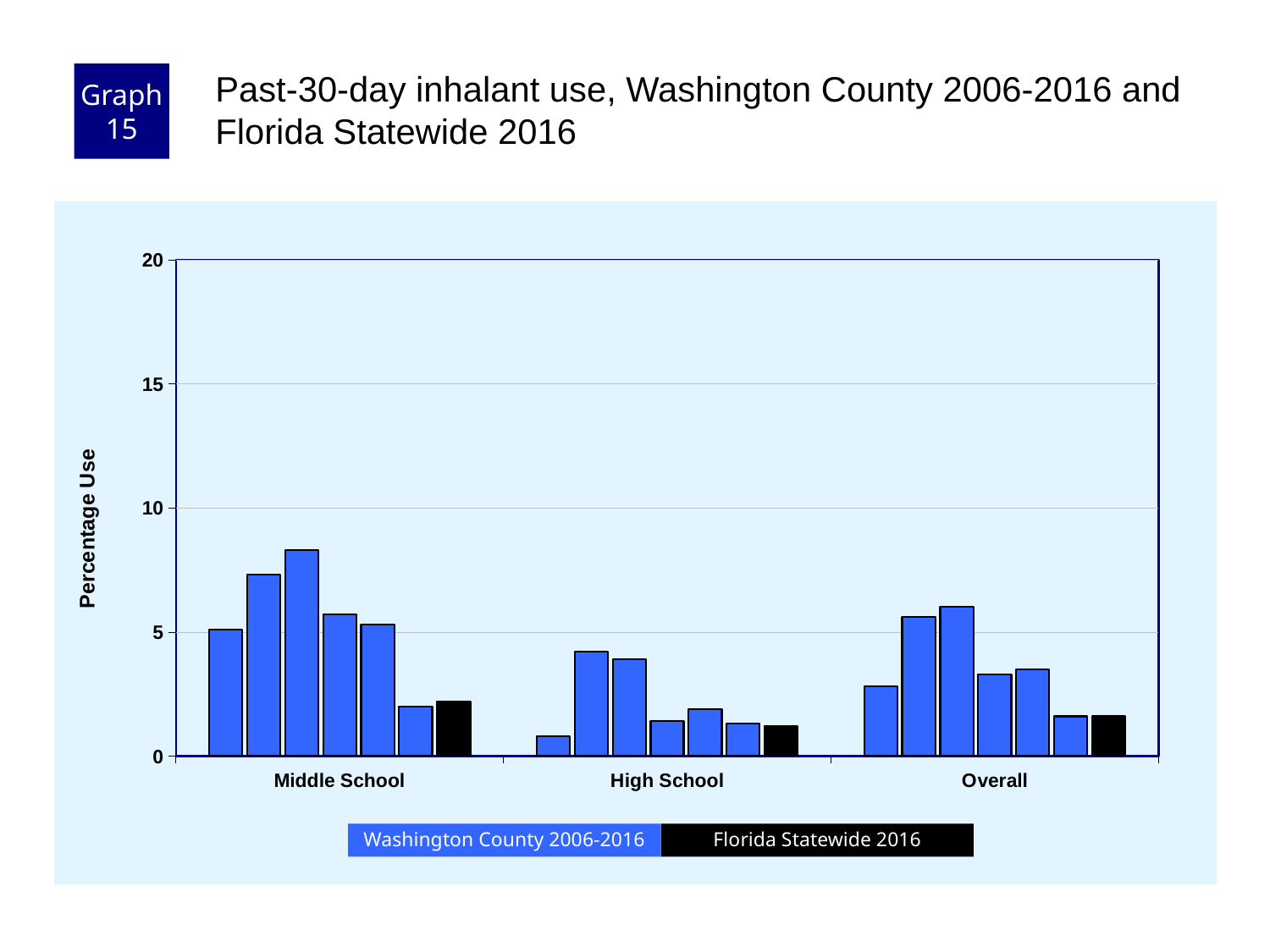
Is the Florida Statewide 2016 value for Middle School greater or less than 5? less What is the label on the y axis? Percentage Use Which school-level group contains the shortest bar in the chart? High School Which is larger, the Florida Statewide 2016 value for Middle School or for High School? Middle School What kind of chart is shown on the slide? bar chart Which school-level group contains the tallest bar in the chart? Middle School Is the tallest Washington County bar in the Middle School group greater or less than 10? less How many school-level categories are shown along the x axis? 3 Is the tallest Washington County bar in the High School group greater or less than 5? less Which colour represents Florida Statewide 2016 in the chart? black How many series does the legend list? 2